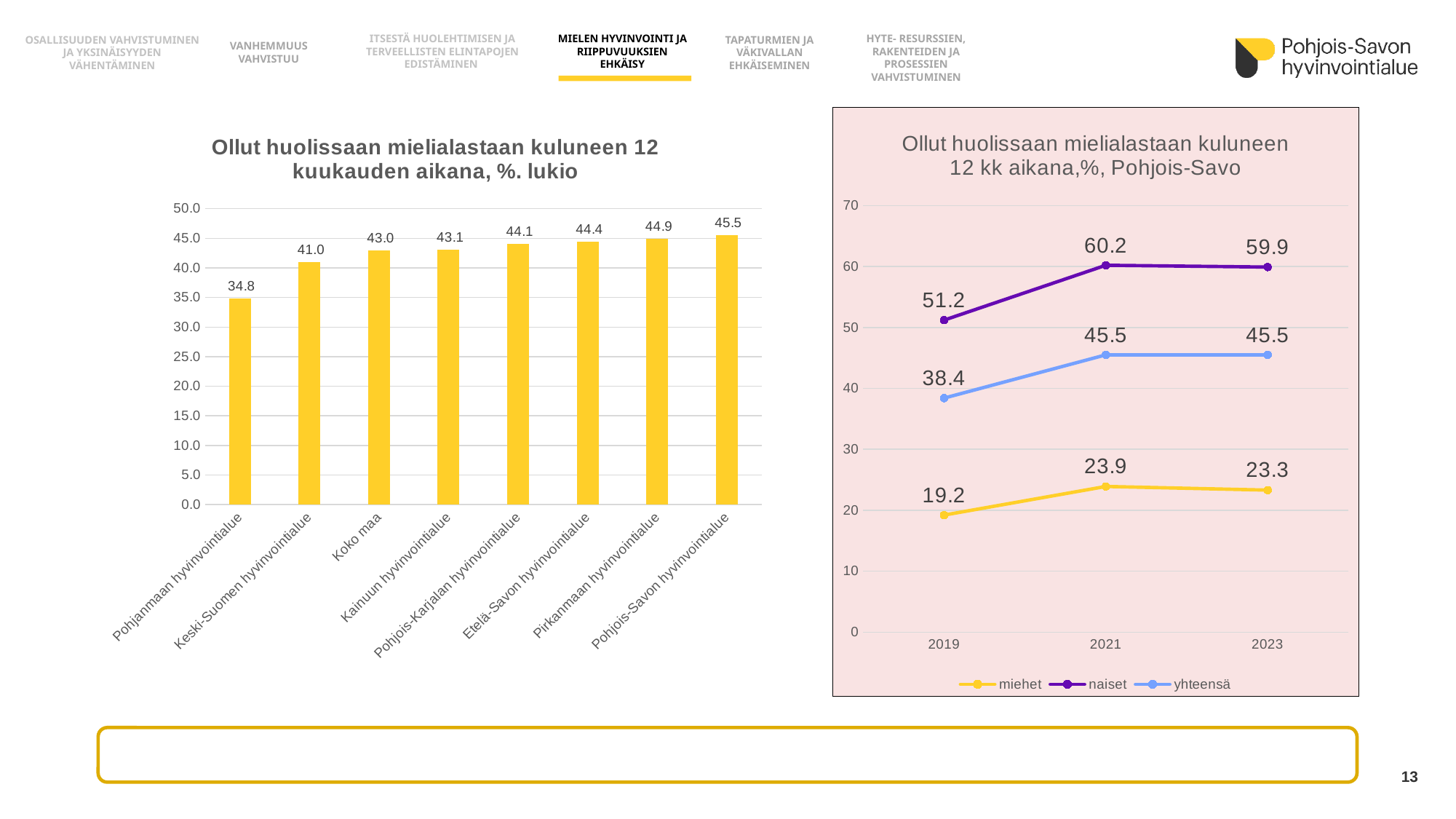
In the bar chart on the left, what is the value for Pohjois-Savon hyvinvointialue? 45.5 In the bar chart on the left, what is the difference between Pohjois-Savon hyvinvointialue and Koko maa? 2.5 What kind of chart is the chart on the left? bar chart In the bar chart on the left, which category has the highest value? Pohjois-Savon hyvinvointialue In the line chart on the right, did the value for yhteensä rise or fall from 2019 to 2021? rise In the line chart on the right, what is the value for miehet in 2019? 19.2 In the line chart on the right, how many series does the legend list? 3 In the bar chart on the left, how many categories are shown? 8 In the bar chart on the left, which category has the lowest value? Pohjanmaan hyvinvointialue In the line chart on the right, what is the value for naiset in 2021? 60.2 In the line chart on the right, what is the difference between naiset and miehet in 2023? 36.6 In the line chart on the right, which series is shown in purple? naiset